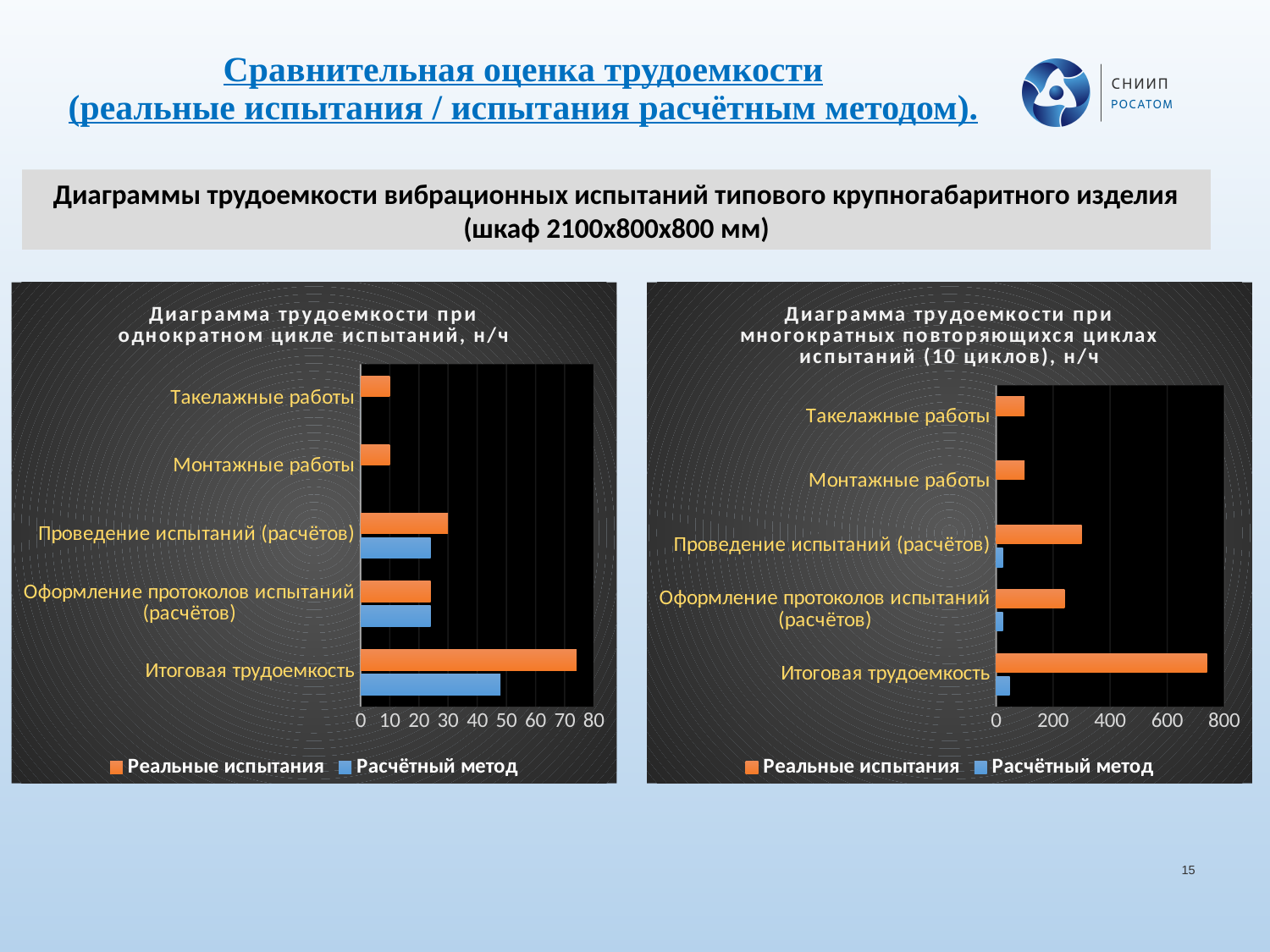
On the right chart, 'Диаграмма трудоемкости при многократных повторяющихся циклах испытаний (10 циклов), н/ч', which category has the highest value for 'Реальные испытания'? Итоговая трудоемкость On the left chart, 'Диаграмма трудоемкости при однократном цикле испытаний, н/ч', is the 'Расчётный метод' value for 'Итоговая трудоемкость' greater or less than 60? less On the right chart, 'Диаграмма трудоемкости при многократных повторяющихся циклах испытаний (10 циклов), н/ч', which is larger for 'Проведение испытаний (расчётов)': 'Реальные испытания' or 'Расчётный метод'? Реальные испытания On the left chart, 'Диаграмма трудоемкости при однократном цикле испытаний, н/ч', is the 'Реальные испытания' value for 'Итоговая трудоемкость' greater or less than 70? greater On the right chart, 'Диаграмма трудоемкости при многократных повторяющихся циклах испытаний (10 циклов), н/ч', is the 'Реальные испытания' value for 'Итоговая трудоемкость' greater or less than 600? greater How many series does the legend of the right chart, 'Диаграмма трудоемкости при многократных повторяющихся циклах испытаний (10 циклов), н/ч', list? 2 On the left chart, 'Диаграмма трудоемкости при однократном цикле испытаний, н/ч', which category has the highest value for 'Реальные испытания'? Итоговая трудоемкость What colour represents the 'Расчётный метод' series in the legend of the left chart? blue What kind of chart is the left chart, 'Диаграмма трудоемкости при однократном цикле испытаний, н/ч'? bar chart How many categories are shown on the left chart, 'Диаграмма трудоемкости при однократном цикле испытаний, н/ч'? 5 On the left chart, 'Диаграмма трудоемкости при однократном цикле испытаний, н/ч', which is larger for 'Итоговая трудоемкость': 'Реальные испытания' or 'Расчётный метод'? Реальные испытания